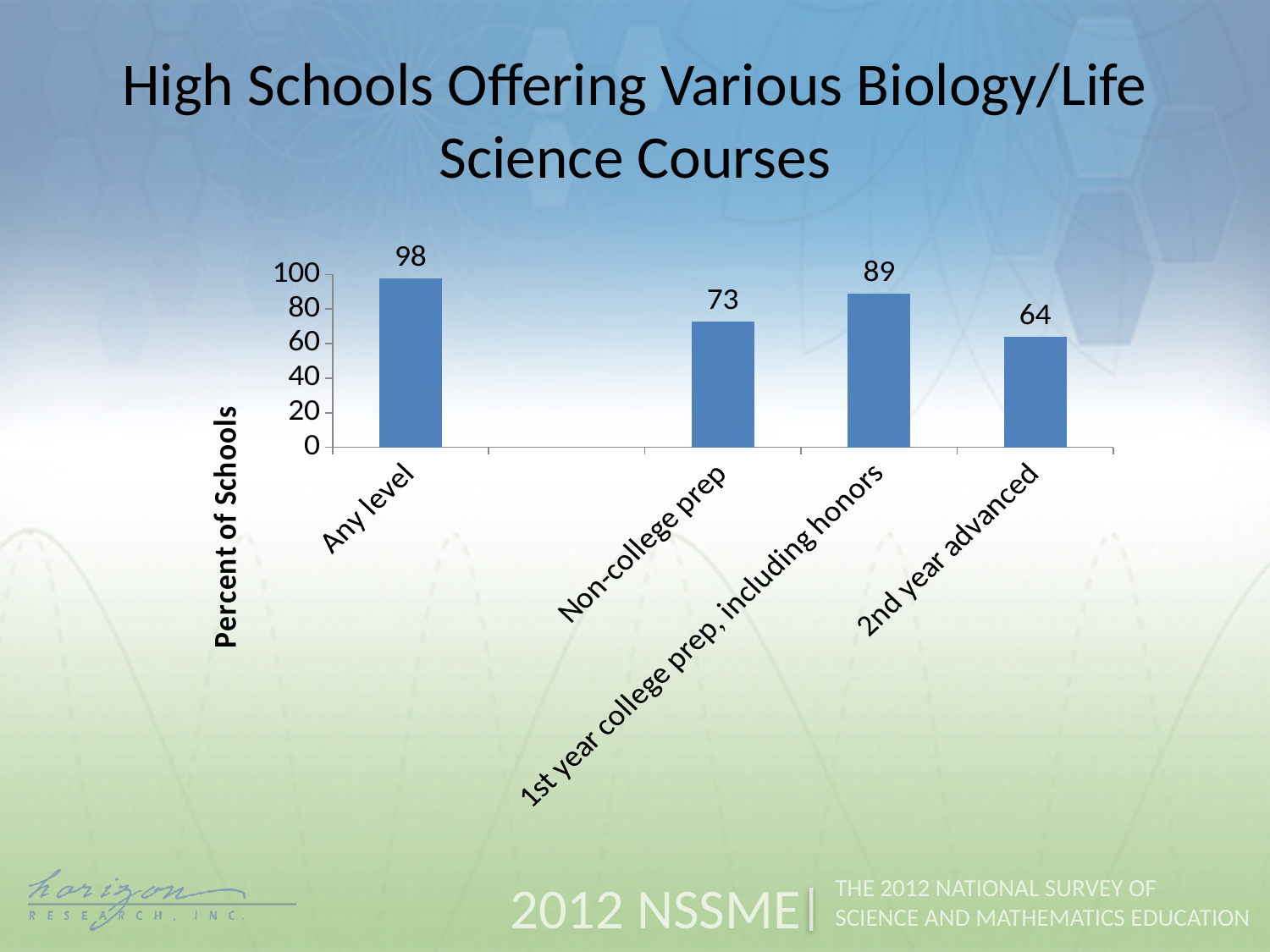
What is the value for 2nd year advanced? 64 Which category has the lowest value? 2nd year advanced How many categories are shown on the chart? 4 What is the difference between the values for 1st year college prep, including honors and Non-college prep? 16 What kind of chart is shown on the slide? bar chart Which category has the highest value? Any level Which is larger, the value for Non-college prep or the value for 1st year college prep, including honors? 1st year college prep, including honors What is the difference between the values for Any level and 2nd year advanced? 34 What is the value for Non-college prep? 73 What percent of high schools offer biology/life science at any level? 98 Is the value for 2nd year advanced greater or less than 80? less What is the value for 1st year college prep, including honors? 89